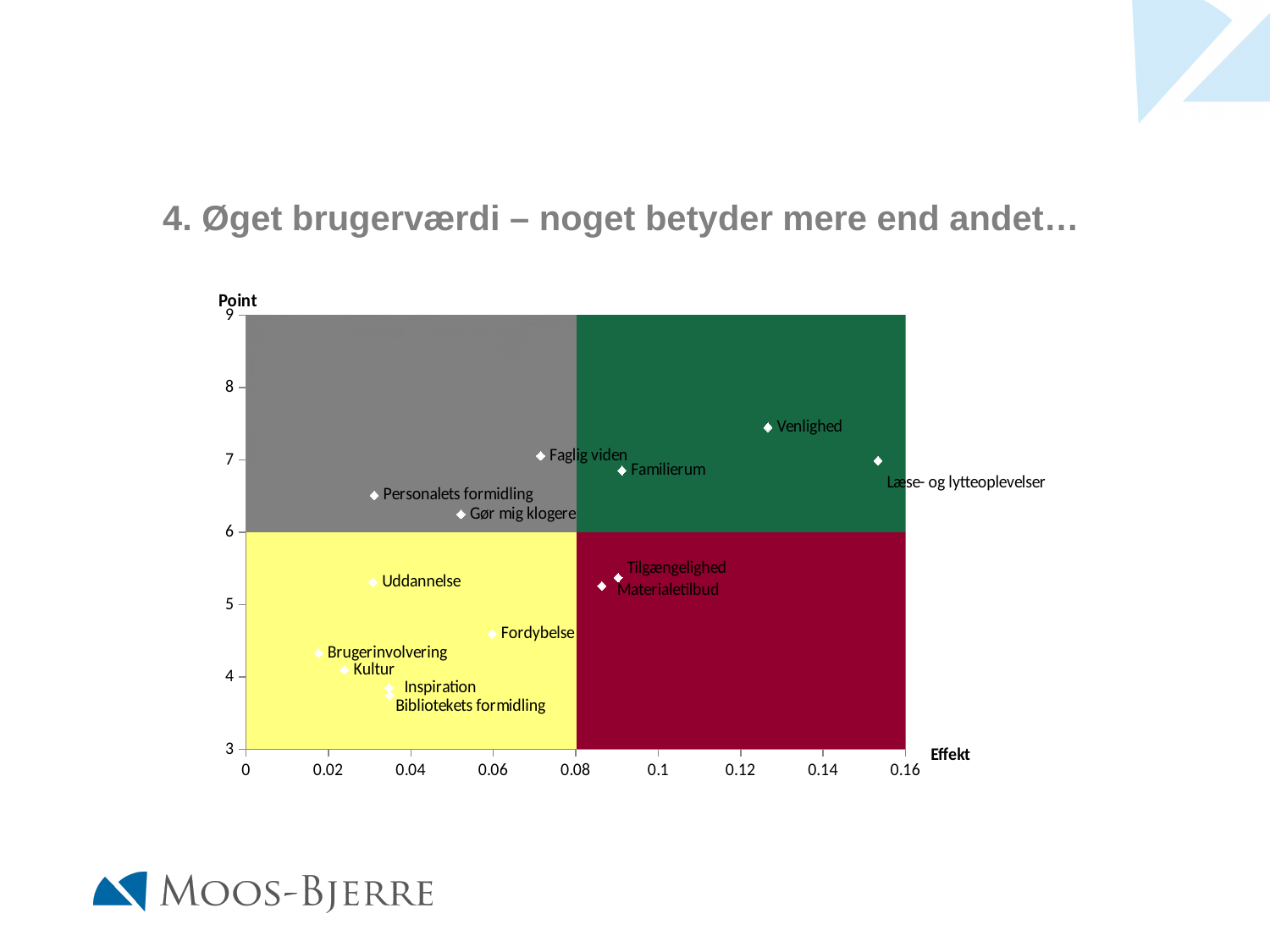
Is the Point value for Venlighed greater or less than 7? greater Which has a higher Point value, Venlighed or Uddannelse? Venlighed Which point has the highest Effekt value? Læse- og lytteoplevelser Which point has the highest Point value? Venlighed How many data points are plotted on the chart? 14 Is the Effekt value for Læse- og lytteoplevelser greater or less than 0.14? greater What is the label of the horizontal axis? Effekt Is the Point value for Fordybelse greater or less than 5? less What is the label of the vertical axis? Point What kind of chart is shown on the slide? scatter chart